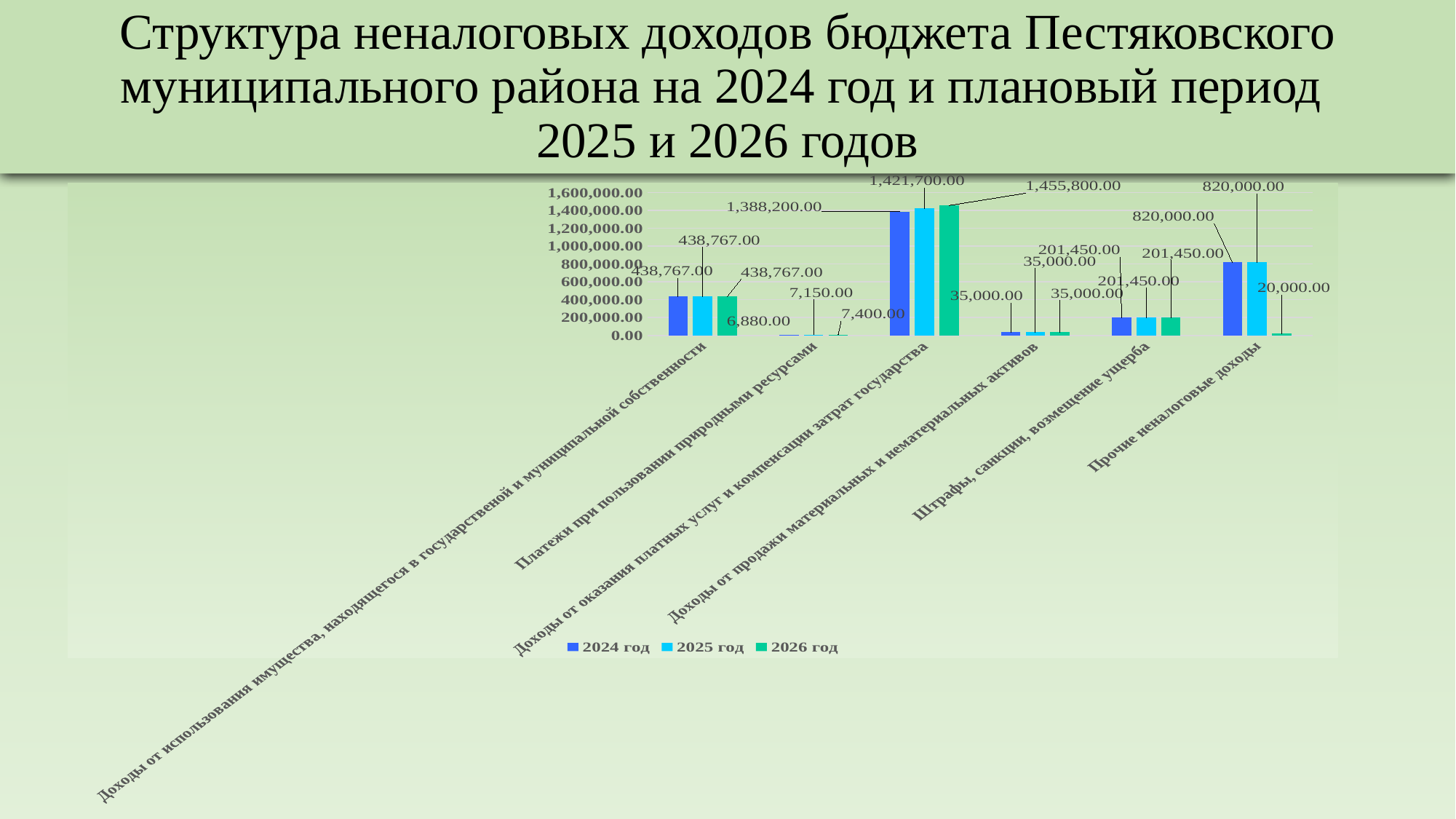
How many categories are shown on the x axis? 6 What are the three legend entries of the chart? 2024 год, 2025 год, 2026 год Which category has the highest value for 2026 год? Доходы от оказания платных услуг и компенсации затрат государства What is the value for 2025 год in the category 'Платежи при пользовании природными ресурсами'? 7,150.00 How many series does the legend list? 3 Which category has the lowest value for 2024 год? Платежи при пользовании природными ресурсами What is the value for 2024 год in the category 'Доходы от оказания платных услуг и компенсации затрат государства'? 1,388,200.00 What kind of chart is shown on the slide? bar chart What is the value for 2026 год in the category 'Прочие неналоговые доходы'? 20,000.00 Do the values for 'Платежи при пользовании природными ресурсами' rise or fall from 2024 год to 2026 год? rise Which is larger for 'Прочие неналоговые доходы': the 2025 год value or the 2026 год value? 2025 год What is the difference between the 2026 год and 2024 год values for 'Доходы от оказания платных услуг и компенсации затрат государства'? 67,600.00